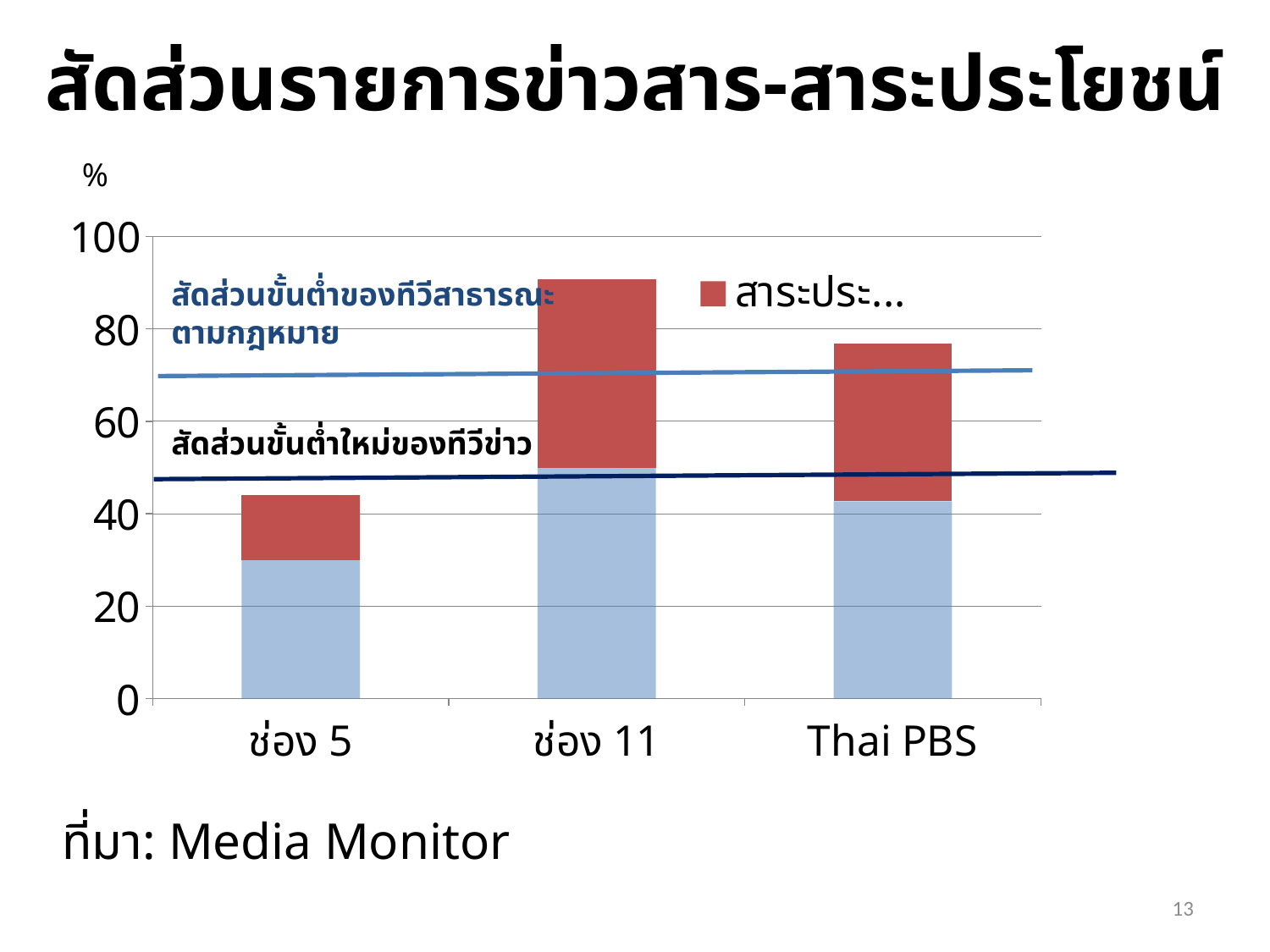
Which category has the tallest stacked bar? ช่อง 11 Is the total value of the bar for Thai PBS greater or less than 60? greater Is the total value of the bar for ช่อง 5 greater or less than 60? less Is the total value of the bar for ช่อง 11 greater or less than 80? greater What source is cited below the chart? Media Monitor What is the title of the slide containing the chart? สัดส่วนรายการข่าวสาร-สาระประโยชน์ Which has the taller stacked bar, ช่อง 11 or Thai PBS? ช่อง 11 Which has the taller stacked bar, ช่อง 5 or Thai PBS? Thai PBS How many categories are shown on the x axis of the chart? 3 What kind of chart is shown on the slide? Stacked bar chart Which category has the shortest stacked bar? ช่อง 5